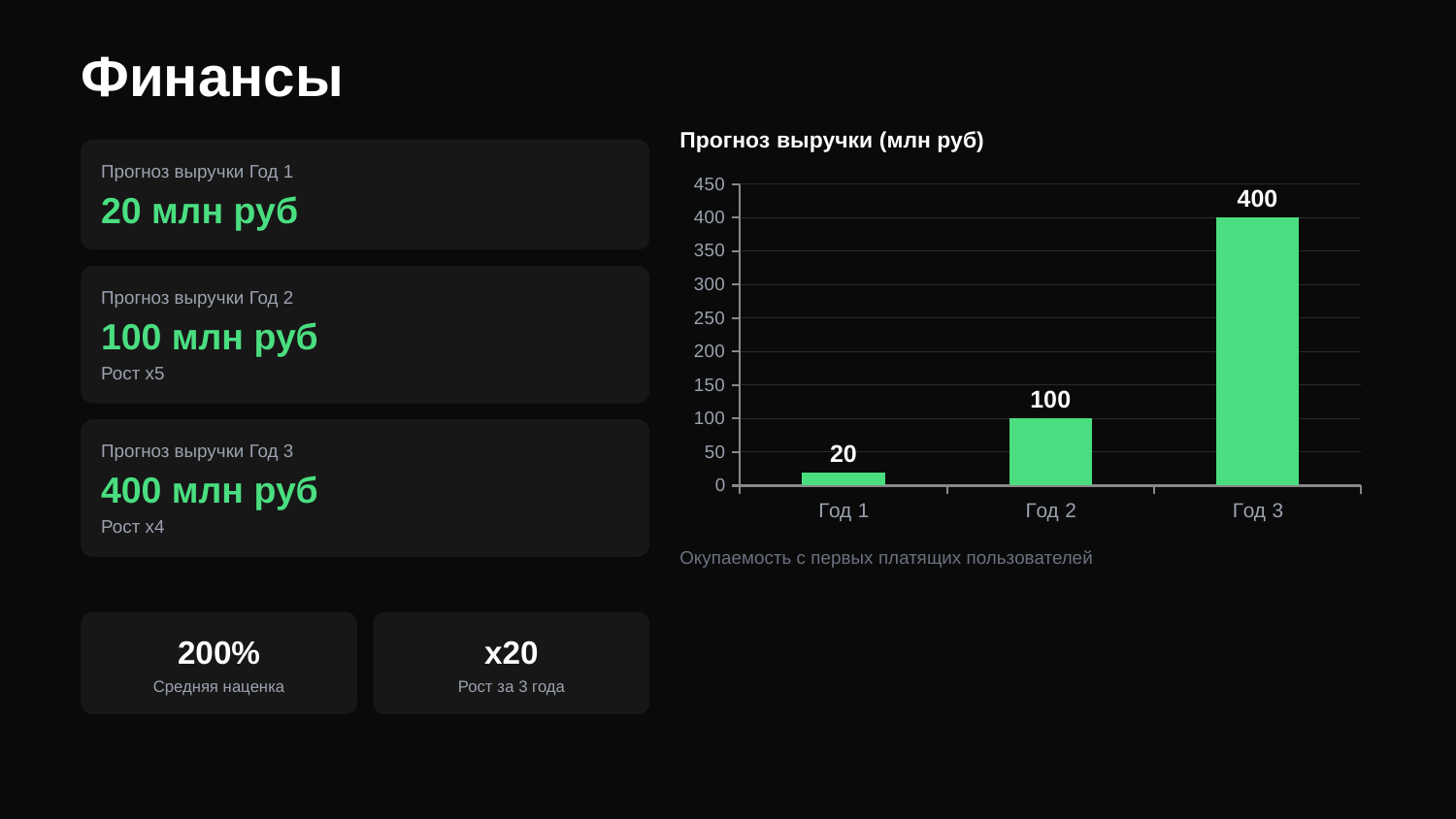
Is the value for Год 3 greater or less than 350? greater Which category has the lowest value in the chart? Год 1 What kind of chart is shown on the slide? bar chart How many categories are shown on the x axis of the chart? 3 Which is larger, the value for Год 2 or the value for Год 1? Год 2 What is the difference between the values for Год 2 and Год 1? 80 Do the values rise or fall from Год 1 to Год 3? rise What is the value for Год 2 in the chart? 100 What is the value for Год 3 in the chart? 400 What is the difference between the values for Год 3 and Год 2? 300 What is the value for Год 1 in the chart? 20 Which category has the highest value in the chart? Год 3